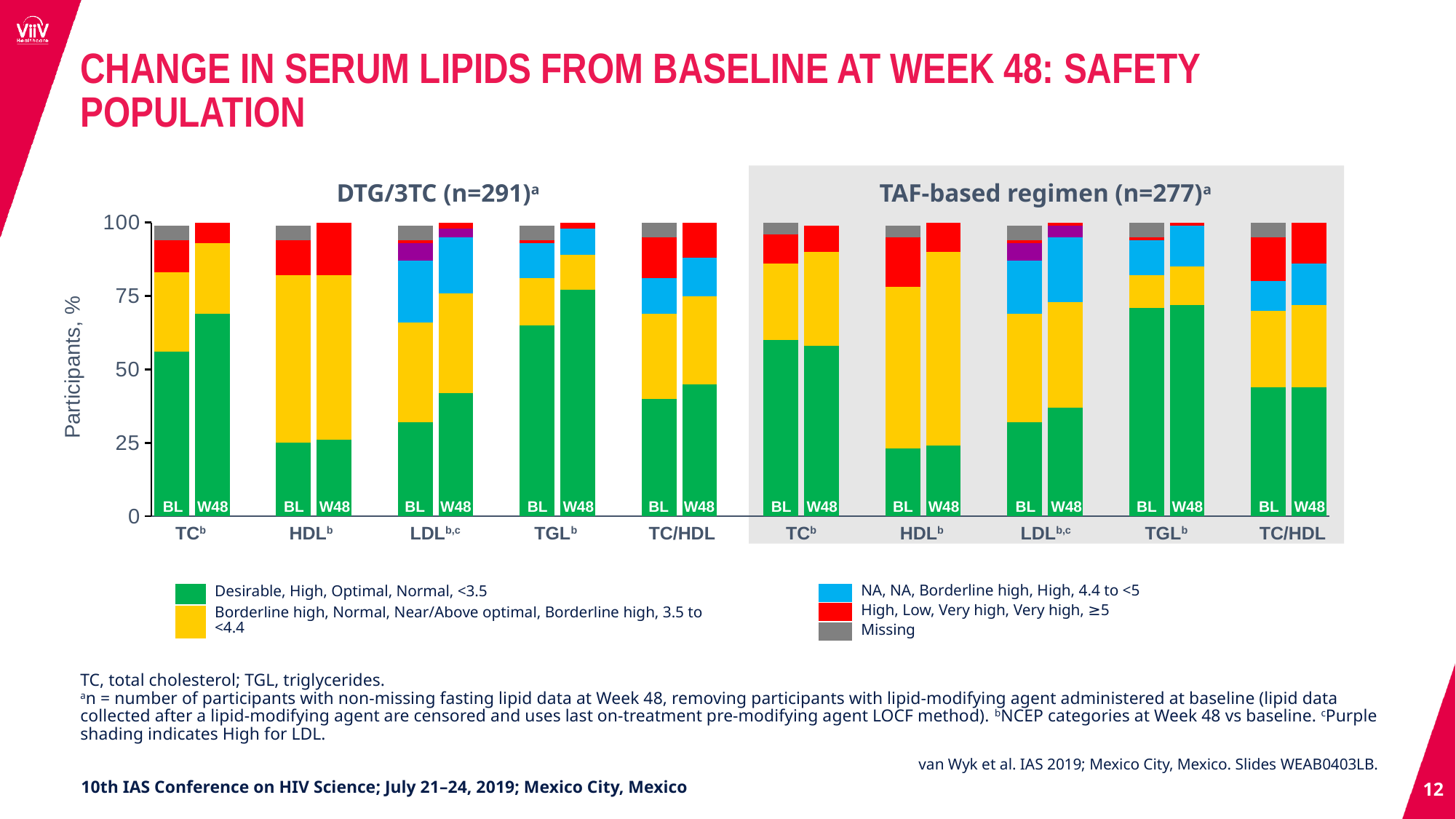
What is the label of the y axis? Participants, % What kind of chart is shown on the slide? Stacked bar chart In the DTG/3TC panel, is the green (Normal) segment for TGL at W48 greater or less than 75? greater In the DTG/3TC panel, is the green (Desirable) segment for TC at BL greater or less than 50? greater In the DTG/3TC panel, does the green (Desirable) share for TC rise or fall from BL to W48? rise In the DTG/3TC panel, is the green (<3.5) segment for TC/HDL at BL greater or less than 50? less In the DTG/3TC panel, is the green (Desirable) segment for TC larger at BL or at W48? W48 How many series does the legend list? 5 How many bars are plotted in total across both panels of the chart? 20 What is the sample size shown for the TAF-based regimen panel? n=277 How many lipid parameters are shown on the x axis for the DTG/3TC (n=291) panel? 5